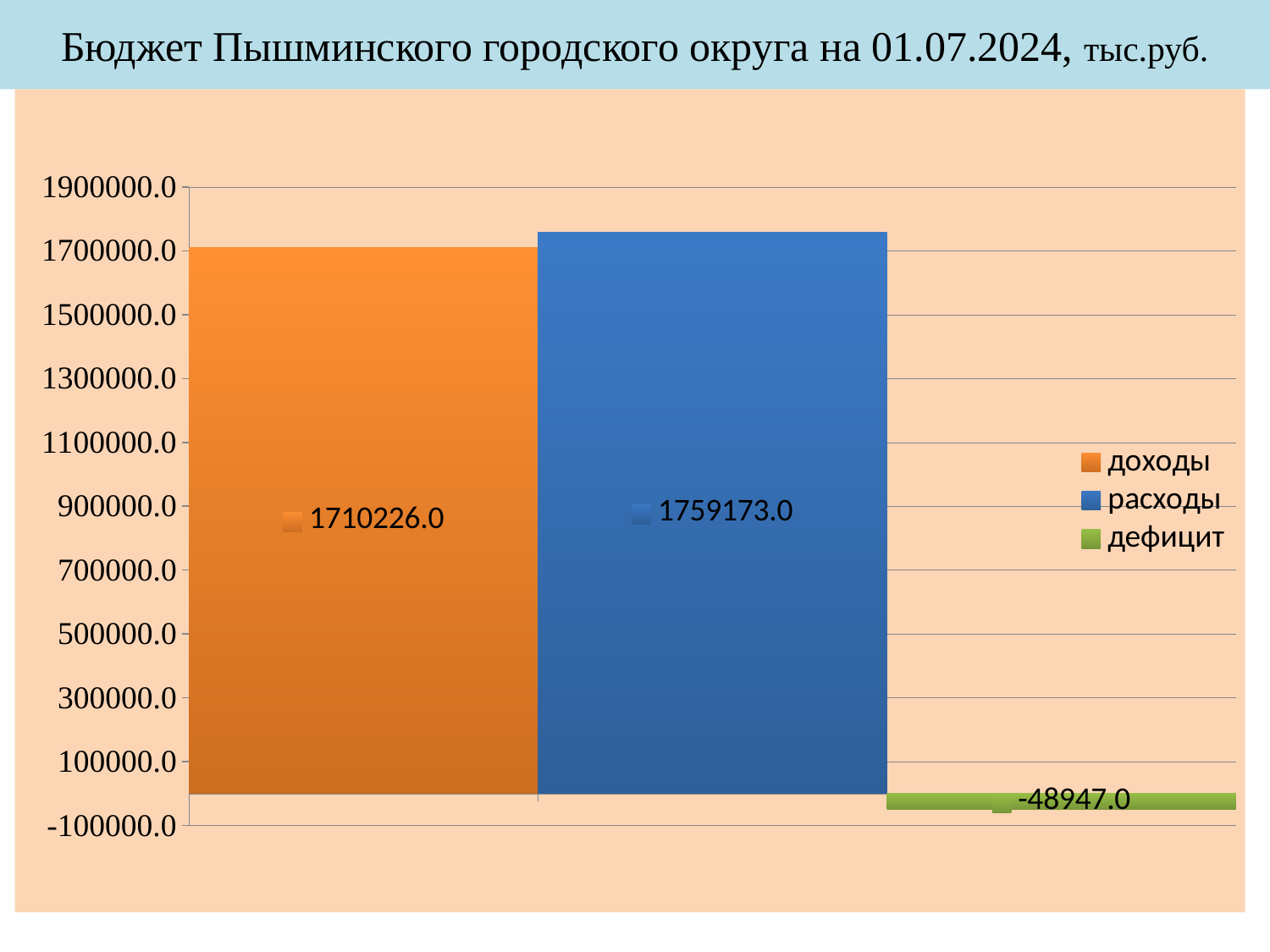
What is the value for доходы? 1710226.0 What kind of chart is shown on the slide? bar chart What is the value for дефицит? -48947.0 Which is larger, доходы or расходы? расходы What is the difference between расходы and доходы? 48947.0 How many series does the legend list? 3 What is the value for расходы? 1759173.0 Which series has the highest value? расходы Which series has the lowest value? дефицит How many bars are plotted on the chart? 3 Is the value for доходы greater or less than 1500000.0? greater Is the value for расходы greater or less than 1900000.0? less